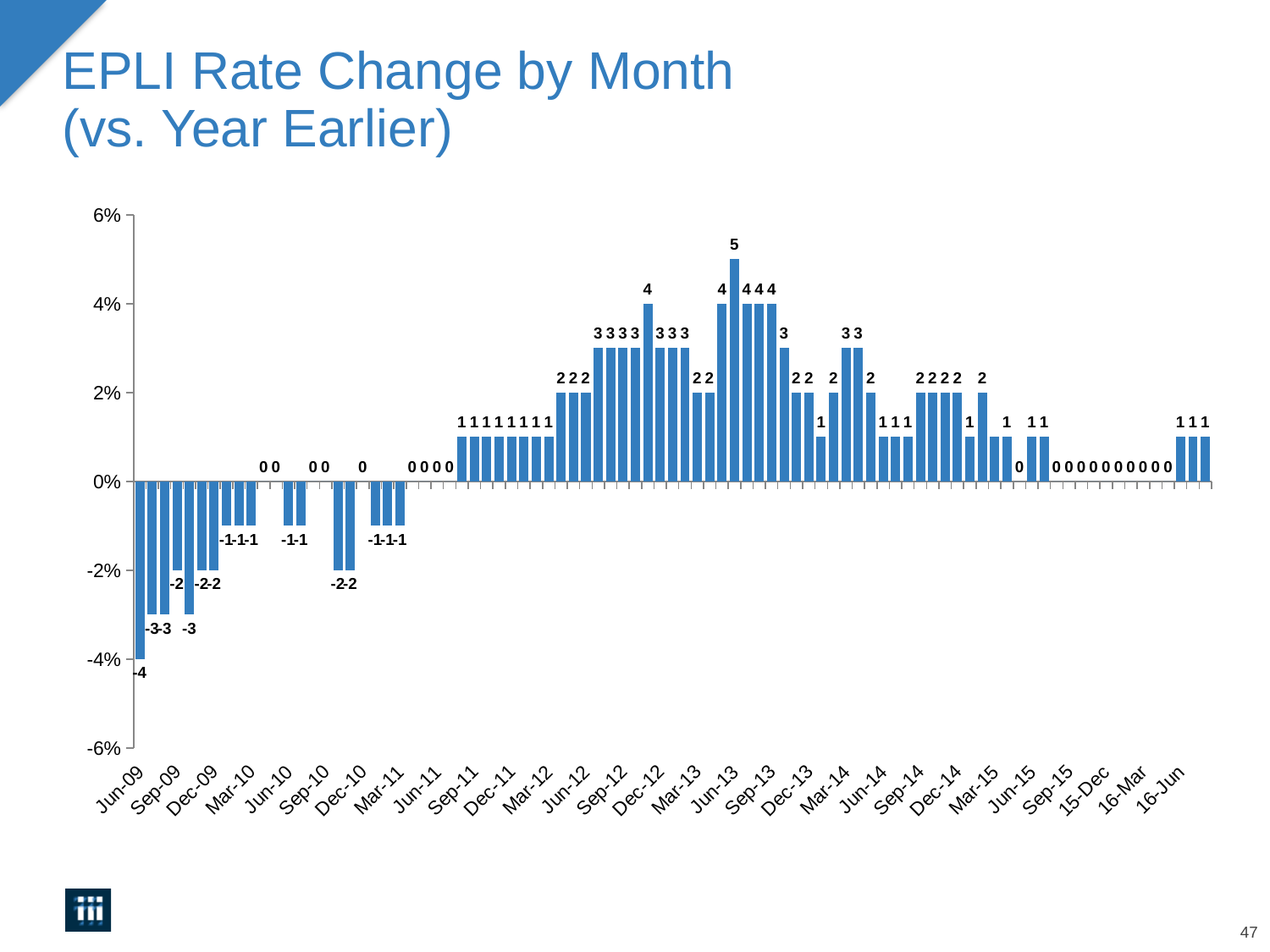
What is the data label on the first bar (Jun-09)? -4 What is the difference between the highest data label (5) and the lowest data label (-4)? 9 Is the value for Jun-09 greater or less than -2%? less Which is larger, the value for Jun-09 or the value for Jun-13? Jun-13 What is the maximum value shown on the vertical axis? 6% What is the highest data label value shown in the chart? 5 What type of chart is shown on the slide? bar chart What is the data label on the tallest bar, located at Jun-13? 5 Do the values generally rise or fall from Jun-09 to Jun-13? rise Is the value for the tallest bar at Jun-13 greater or less than 4%? greater What is the title of the chart? EPLI Rate Change by Month (vs. Year Earlier) What is the lowest data label value shown in the chart? -4